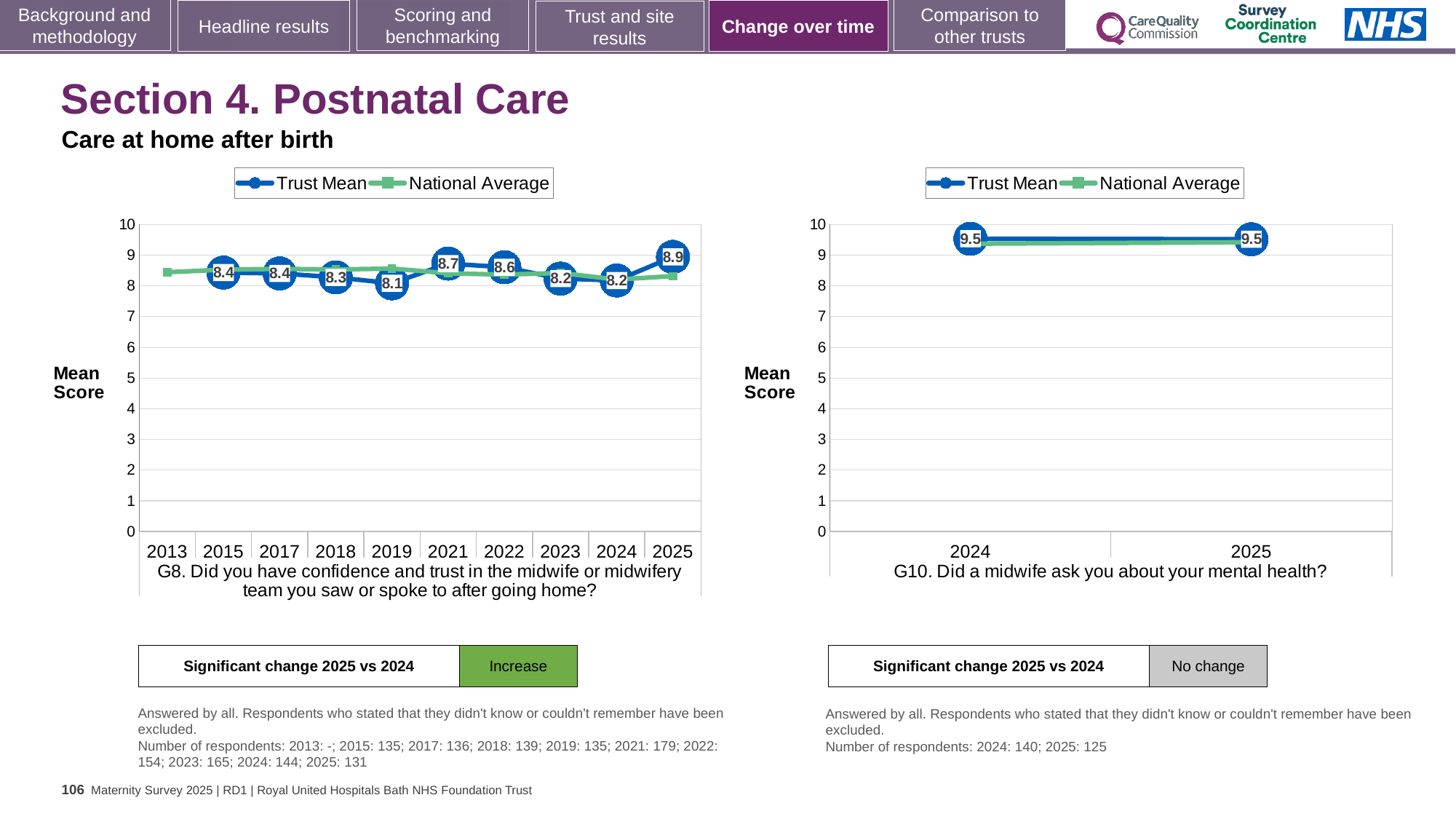
On the left chart (G8), which year has the lowest labelled Trust Mean? 2019 On the left chart (G8), what is the Trust Mean for 2019? 8.1 On the right chart (G10), what is the Trust Mean for 2024? 9.5 On the left chart (G8), is the National Average for 2013 greater or less than 8? greater On the left chart (G8), what is the difference between the Trust Mean for 2025 and for 2024? 0.7 On the right chart (G10), does the Trust Mean rise, fall or stay the same from 2024 to 2025? stays the same How many years are shown on the x axis of the left chart (G8)? 10 On the left chart (G8), which year has the highest Trust Mean? 2025 How many series does the legend of the left chart (G8) list? 2 What kind of chart is the left chart (G8)? line chart On the left chart (G8), what is the Trust Mean for 2025? 8.9 On the left chart (G8), which year has the higher Trust Mean, 2021 or 2022? 2021